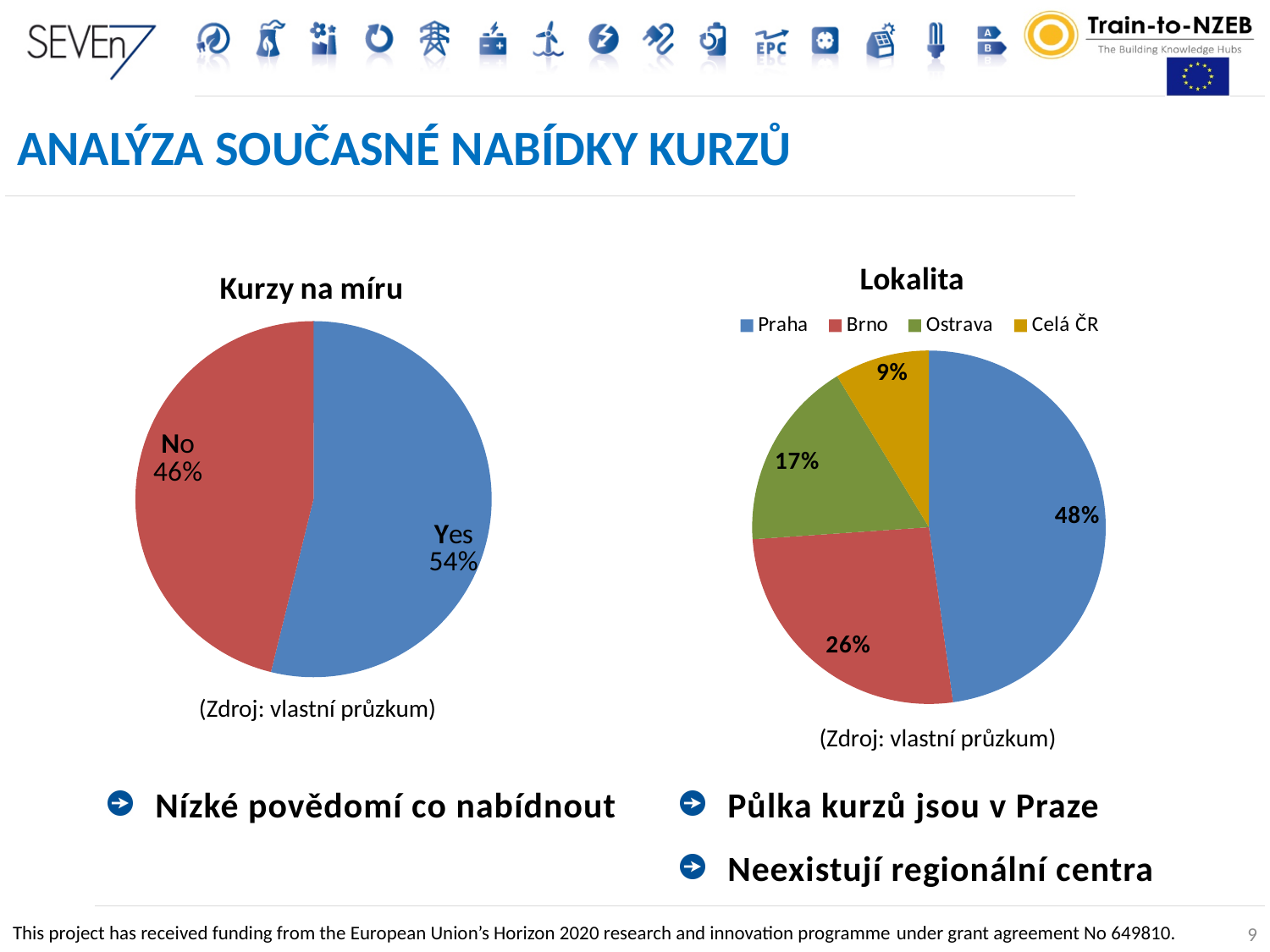
In the 'Kurzy na míru' chart, what share is labelled 'No'? 46% What kind of chart is 'Kurzy na míru'? Pie chart In the 'Kurzy na míru' chart, what is the difference between the 'Yes' and 'No' shares? 8% In the 'Lokalita' chart, which category has the smallest share? Celá ČR In the 'Lokalita' chart, what is the difference between the Praha and Brno shares? 22% In the 'Lokalita' chart, what share does Brno have? 26% In the 'Lokalita' chart, what share does Praha have? 48% In the 'Lokalita' chart, which category has the largest share? Praha In the 'Kurzy na míru' chart, what share is labelled 'Yes'? 54% In the 'Lokalita' chart, what share does Ostrava have? 17% How many categories does the legend of the 'Lokalita' chart list? 4 In the 'Kurzy na míru' chart, which slice is larger, 'Yes' or 'No'? Yes